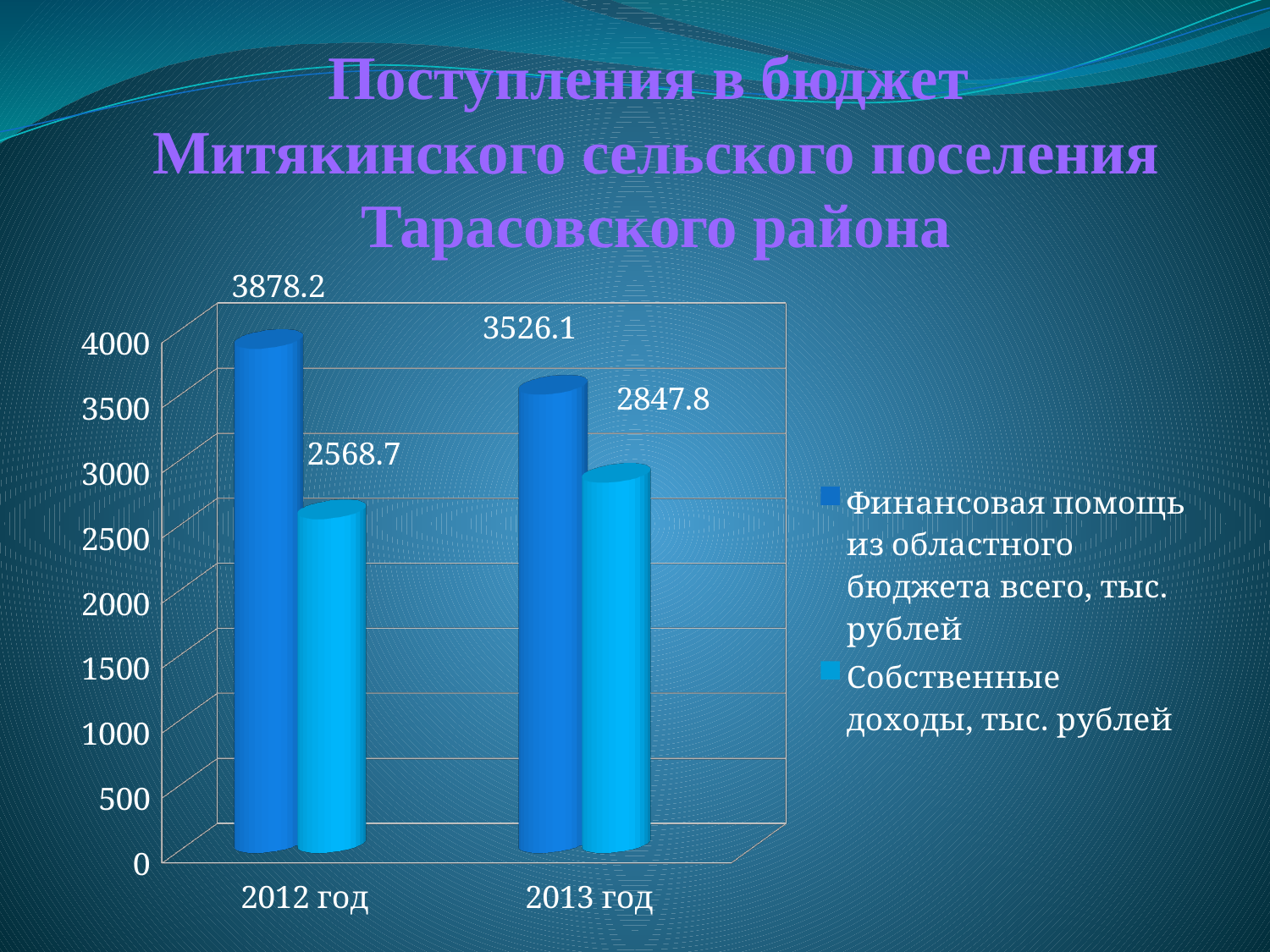
How many series does the legend list? 2 In which year is Финансовая помощь из областного бюджета highest? 2012 год Which is larger in 2013 год: Финансовая помощь из областного бюджета or Собственные доходы? Финансовая помощь из областного бюджета In which year is Собственные доходы lowest? 2012 год By how much did Собственные доходы change from 2012 год to 2013 год? 279.1 What is the value of Финансовая помощь из областного бюджета for 2013 год? 3526.1 What is the value of Собственные доходы for 2012 год? 2568.7 How many years are shown on the x axis? 2 What is the difference between Финансовая помощь из областного бюджета and Собственные доходы in 2012 год? 1309.5 What is the value of Собственные доходы for 2013 год? 2847.8 What is the value of Финансовая помощь из областного бюджета for 2012 год? 3878.2 What kind of chart is shown on the slide? Bar chart